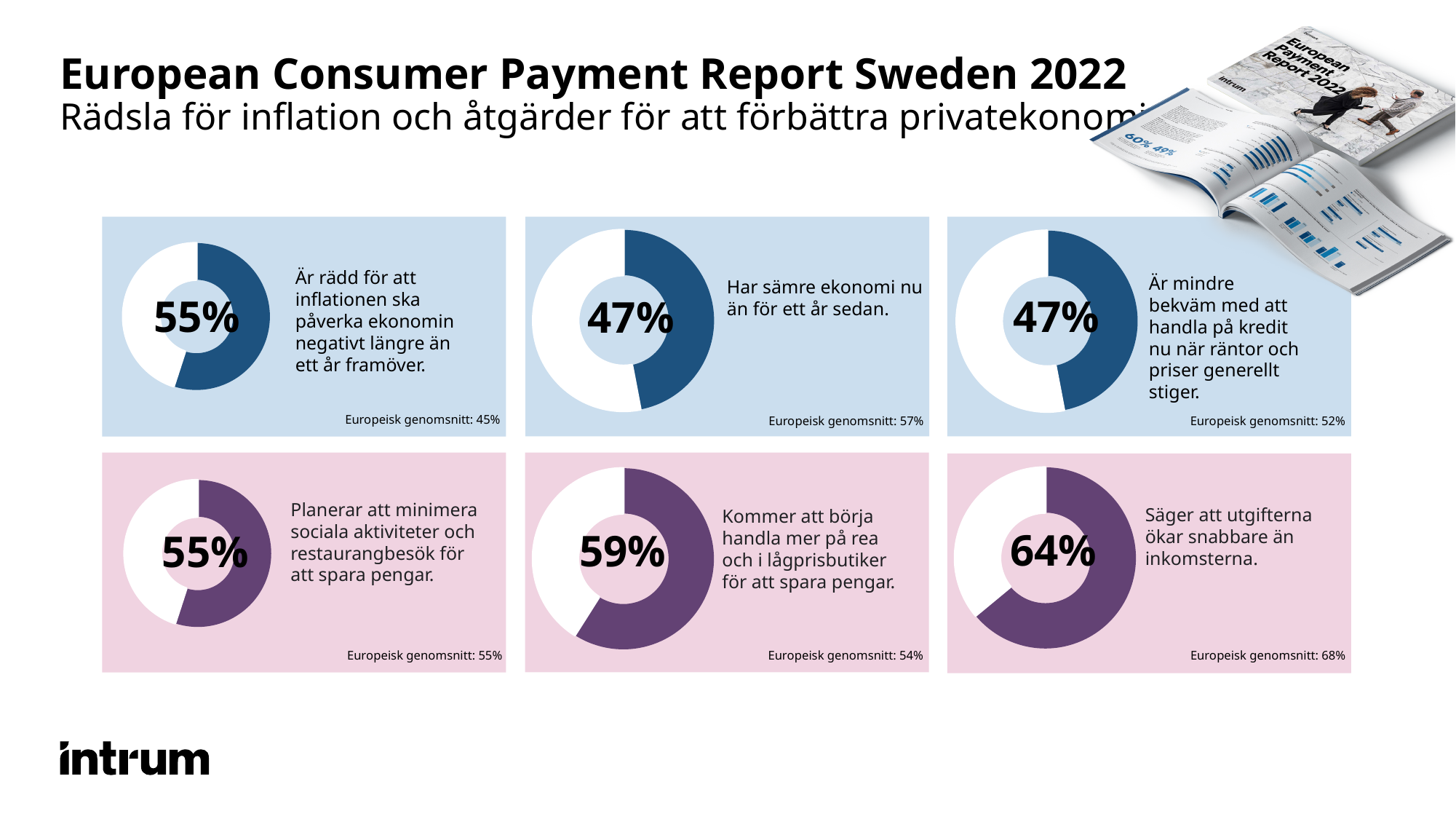
Which of the six donut charts shows the highest percentage? Bottom-right (64%) What is the European average (Europeisk genomsnitt) given for the top-left donut chart? 45% What type of chart is used on the slide? Donut (pie) chart What is the European average (Europeisk genomsnitt) given for the bottom-middle donut chart? 54% How many donut charts are on the slide? 6 What percentage is shown in the top-middle donut chart (worse finances now than a year ago)? 47% In the bottom-right donut chart, which is larger: the Swedish value or the European average? The European average (68%) What is the difference between the Swedish value and the European average in the top-left donut chart? 10 percentage points What colour are the filled segments of the three donut charts in the bottom row? Purple What percentage is shown in the top-left donut chart (afraid inflation will negatively affect finances for more than a year)? 55% What percentage is shown in the bottom-right donut chart (expenses increasing faster than income)? 64% What is the lowest percentage shown across the six donut charts? 47%